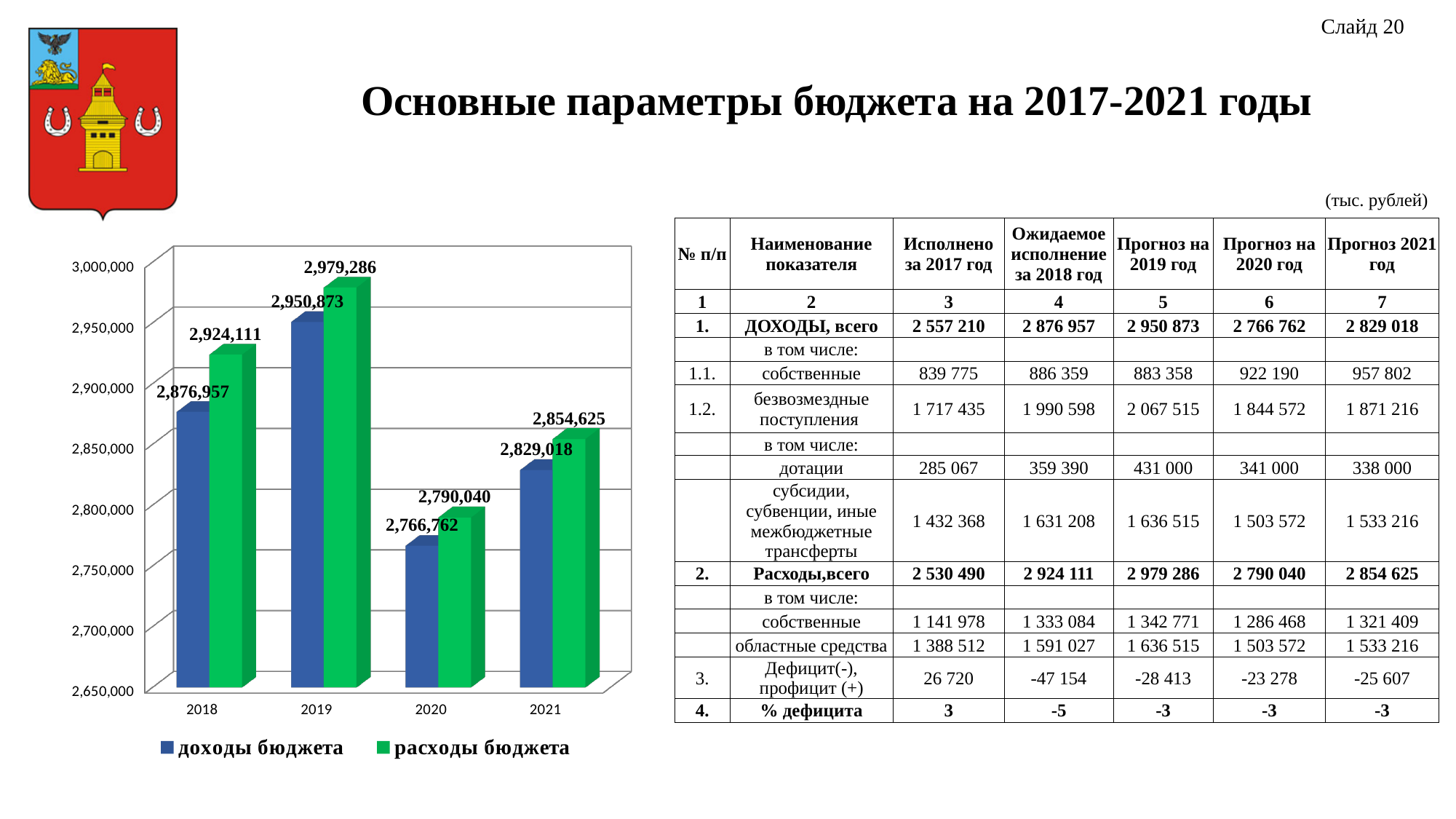
What is the value of доходы бюджета for 2021 in the chart? 2,829,018 What type of chart is shown on the slide? bar chart Is the value of расходы бюджета for 2020 greater or less than 2,800,000? less What is the difference between расходы бюджета and доходы бюджета for 2018 in the chart? 47,154 What is the value of расходы бюджета for 2020 in the chart? 2,790,040 How many series does the chart legend list? 2 In which year is расходы бюджета highest in the chart? 2019 What is the value of доходы бюджета for 2019 in the chart? 2,950,873 Which is larger in the chart: доходы бюджета for 2018 or доходы бюджета for 2021? доходы бюджета for 2018 How many years are shown on the x axis of the chart? 4 What is the difference between расходы бюджета and доходы бюджета for 2021 in the chart? 25,607 In which year is доходы бюджета lowest in the chart? 2020